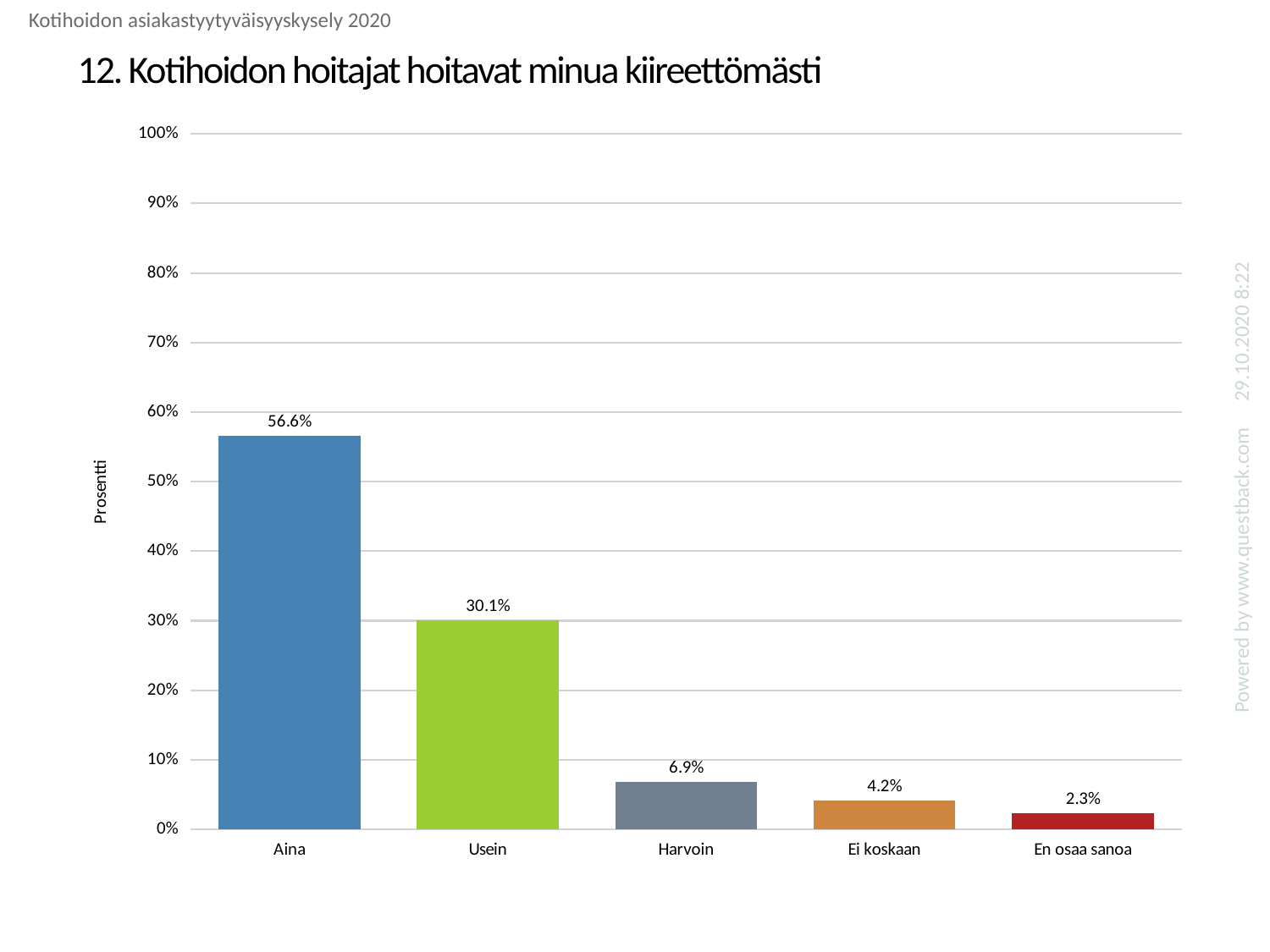
What is the label of the y axis? Prosentti What kind of chart is shown on the slide? Bar chart What is the difference between the values for Aina and Usein? 26.5% How many categories are shown on the x axis? 5 What is the value for Usein? 30.1% Which category has the highest value? Aina What is the value for En osaa sanoa? 2.3% Which category has the lowest value? En osaa sanoa Which is larger, the value for Harvoin or the value for Ei koskaan? Harvoin What is the value for Ei koskaan? 4.2% What is the value for Harvoin? 6.9% What is the value for Aina? 56.6%